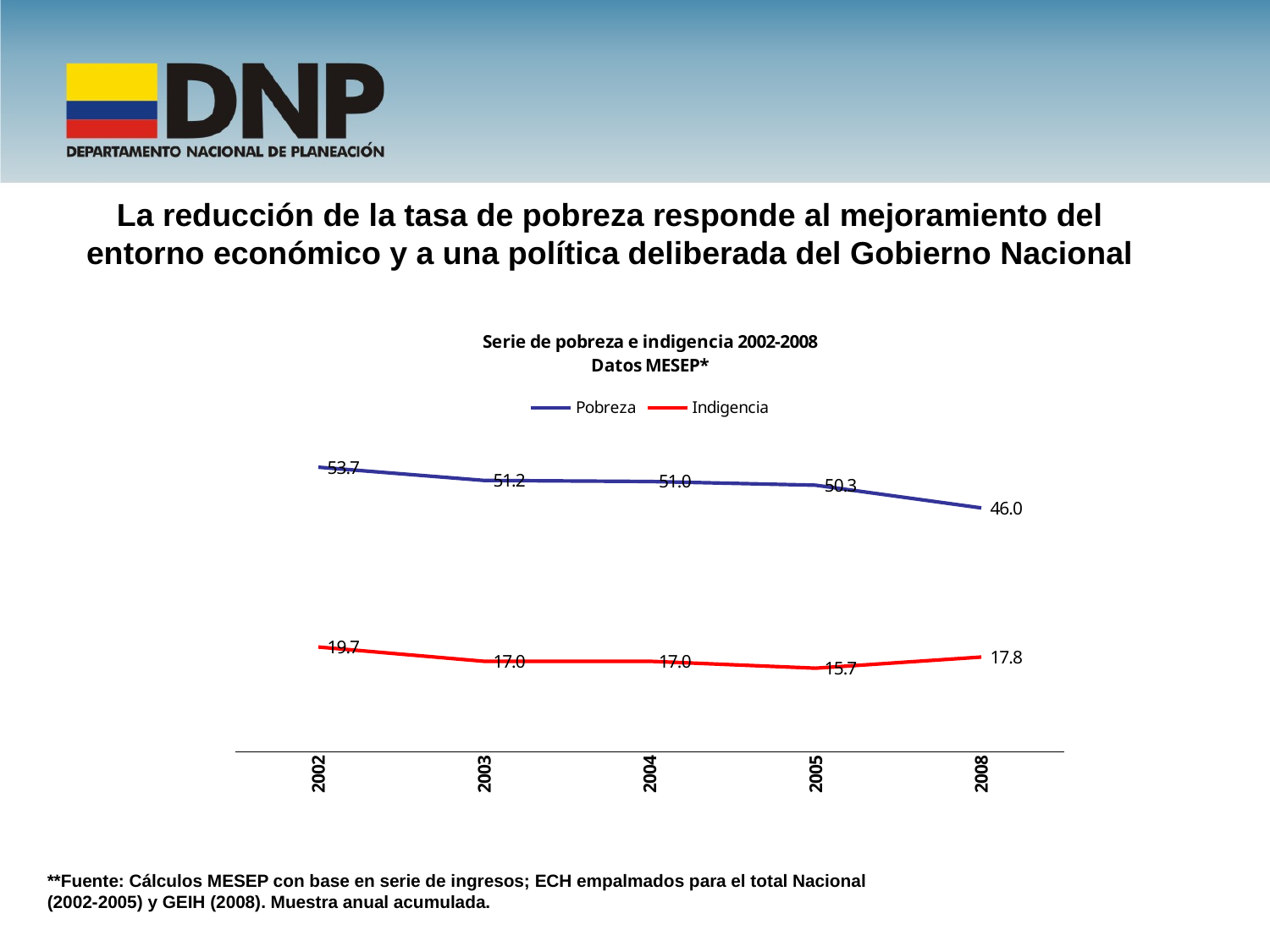
In which year is the Indigencia series highest? 2002 How many series does the legend list? 2 Which is larger, the Indigencia value for 2003 or for 2008? 2008 What is the Indigencia value for 2005? 15.7 What is the Pobreza value for 2002? 53.7 What kind of chart is shown on the slide? Line chart What is the Pobreza value for 2008? 46.0 What is the Indigencia value for 2008? 17.8 How many years are shown on the x axis? 5 In which year is the Pobreza series lowest? 2008 Does the Pobreza series rise or fall from 2002 to 2008? Fall What is the difference between the Pobreza values for 2002 and 2008? 7.7